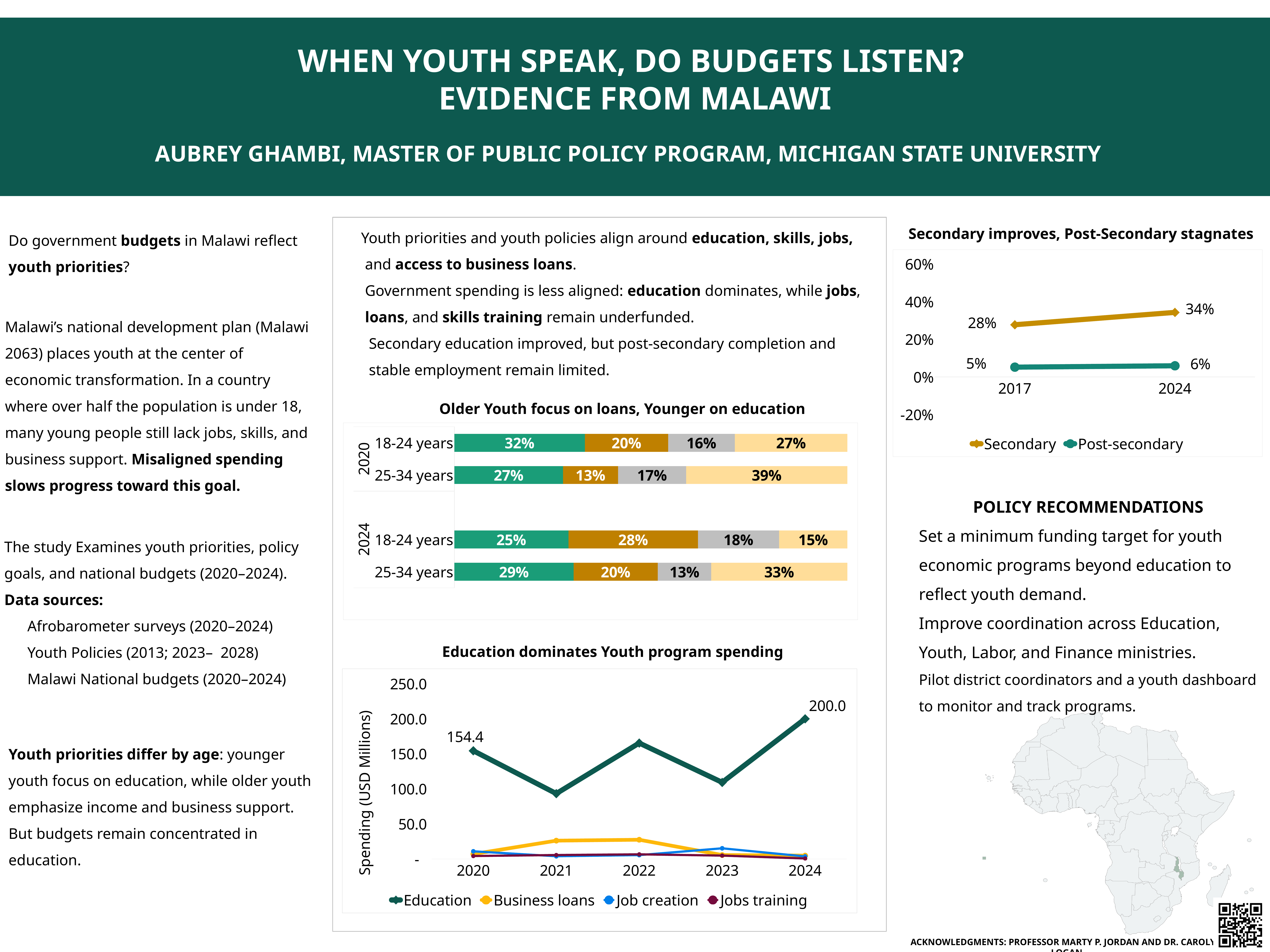
In the chart titled 'Secondary improves, Post-Secondary stagnates', which series has the higher value in 2024, Secondary or Post-secondary? Secondary In the chart titled 'Secondary improves, Post-Secondary stagnates', what is the Post-secondary value in 2017? 5% In the chart titled 'Education dominates Youth program spending', what is the Education spending value in 2020? 154.4 In the chart titled 'Education dominates Youth program spending', how many years are shown on the x axis? 5 In the chart titled 'Secondary improves, Post-Secondary stagnates', by how many percentage points did the Secondary value change from 2017 to 2024? 6 percentage points In the chart titled 'Education dominates Youth program spending', what is the Education spending value in 2024? 200.0 What kind of chart is 'Older Youth focus on loans, Younger on education'? stacked bar chart In the chart titled 'Education dominates Youth program spending', how many series does the legend list? 4 What kind of chart is 'Education dominates Youth program spending'? line chart In the chart titled 'Secondary improves, Post-Secondary stagnates', what is the Secondary value in 2024? 34% In the chart titled 'Older Youth focus on loans, Younger on education', what is the total of the segments in the 2024 18-24 years bar? 86%